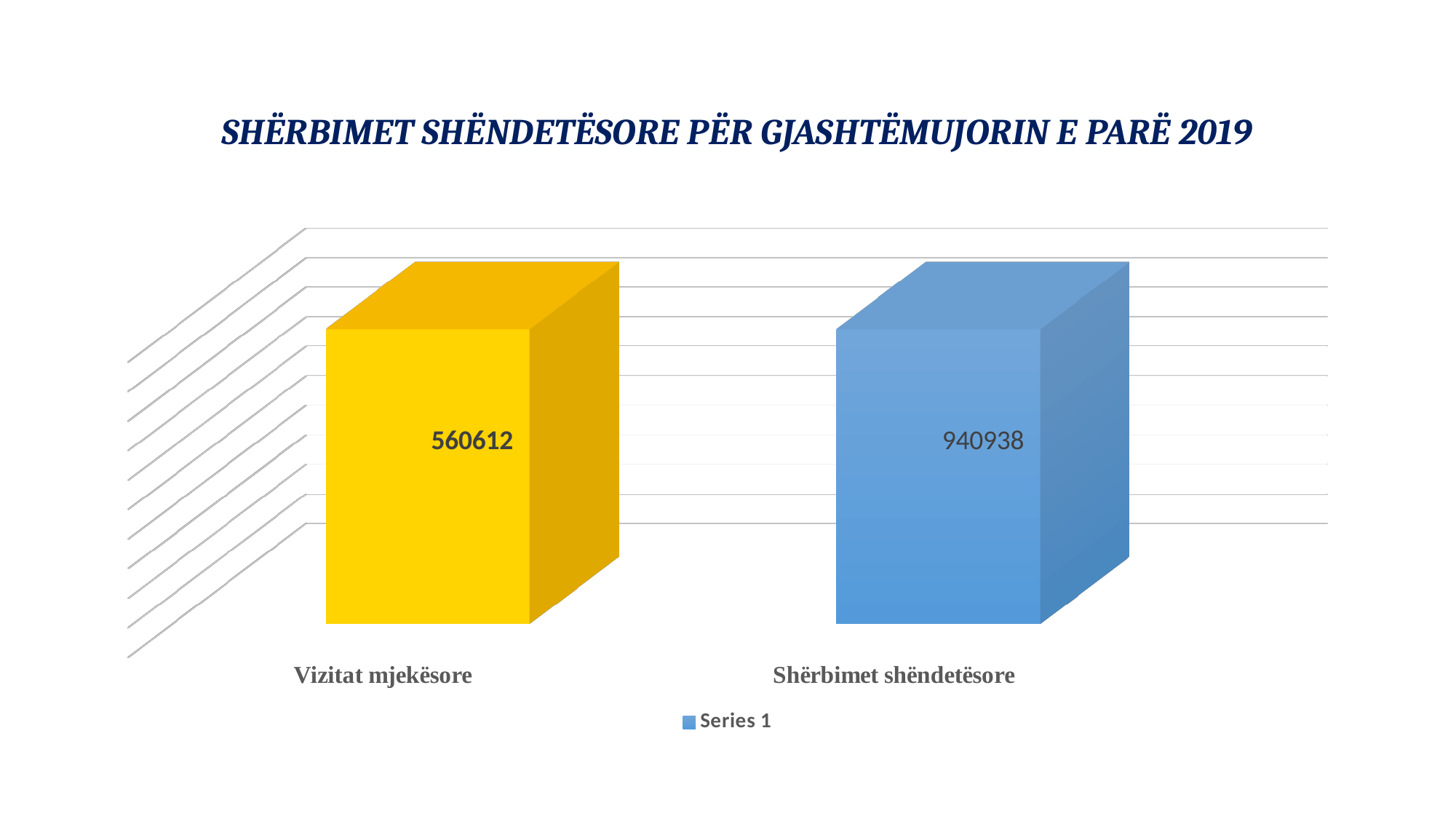
What is the value for Vizitat mjekësore? 560612 What is the value for Shërbimet shëndetësore? 940938 Which is larger according to the data labels: Vizitat mjekësore or Shërbimet shëndetësore? Shërbimet shëndetësore How many categories are shown on the chart? 2 How many series does the legend list? 1 What is the difference between the values for Shërbimet shëndetësore and Vizitat mjekësore? 380326 What is the title of the chart? SHËRBIMET SHËNDETËSORE PËR GJASHTËMUJORIN E PARË 2019 Which category has the highest value according to the data labels? Shërbimet shëndetësore Which category has the lowest value according to the data labels? Vizitat mjekësore What is the name of the series listed in the legend? Series 1 What kind of chart is shown on the slide? Bar chart What is the sum of the two values shown on the chart? 1501550